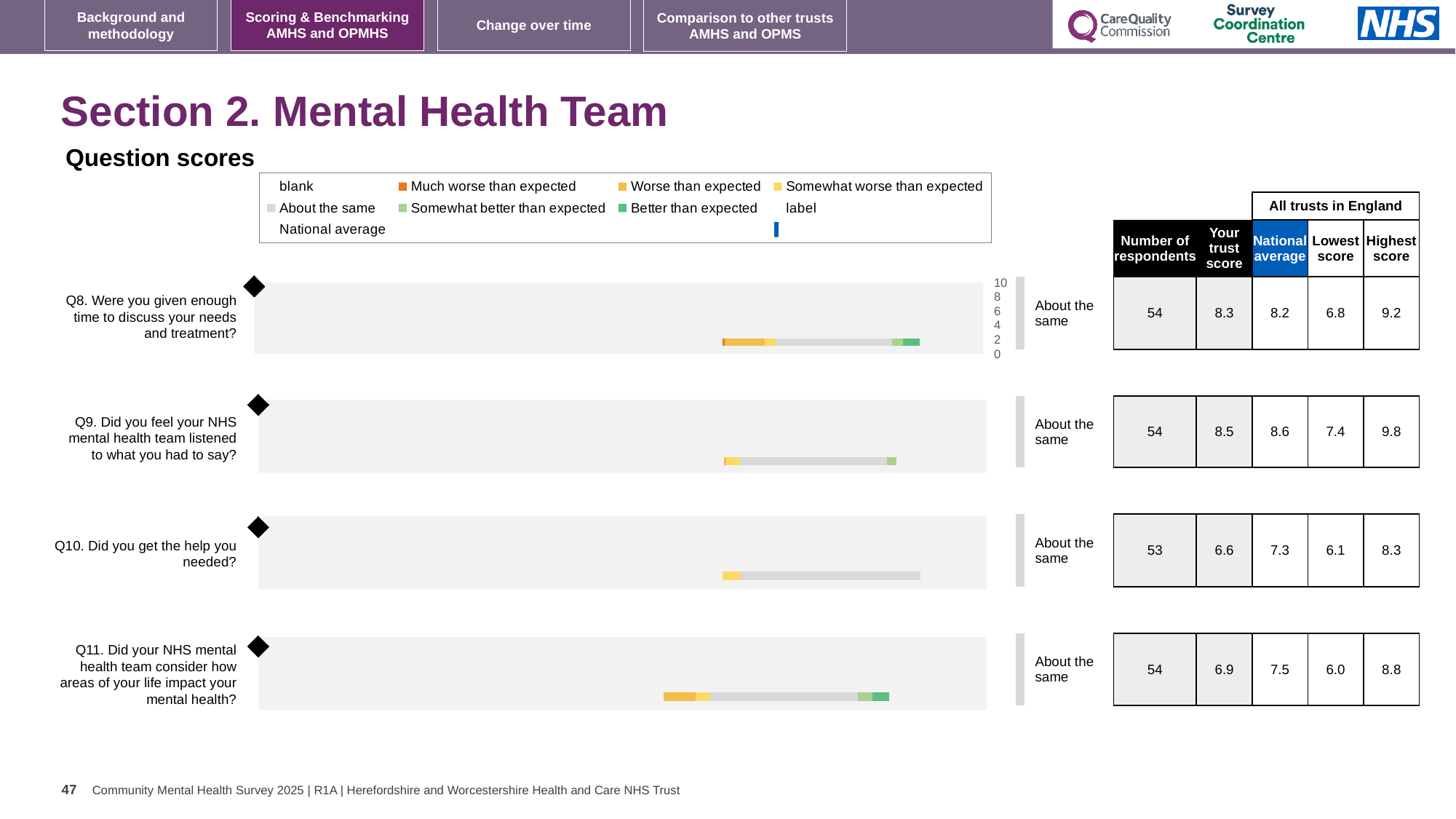
What kind of chart is used to show the question scores for Q8 to Q11? bar chart For Q11, what is the difference between the national average and the trust score? 0.6 Which question has the highest trust score? Q9 For Q9, which is larger: the trust score or the national average? national average What benchmark category is shown next to the Q10 chart? About the same For Q11 (Did your NHS mental health team consider how areas of your life impact your mental health?), how many respondents are there? 54 For Q10, what is the lowest score among all trusts in England? 6.1 How many questions (Q8 to Q11) have a score chart on the slide? 4 For Q8, what is the highest score among all trusts in England? 9.2 Which question has the lowest trust score? Q10 For Q10 (Did you get the help you needed?), what is the national average score? 7.3 For Q8 (Were you given enough time to discuss your needs and treatment?), what is the trust score? 8.3